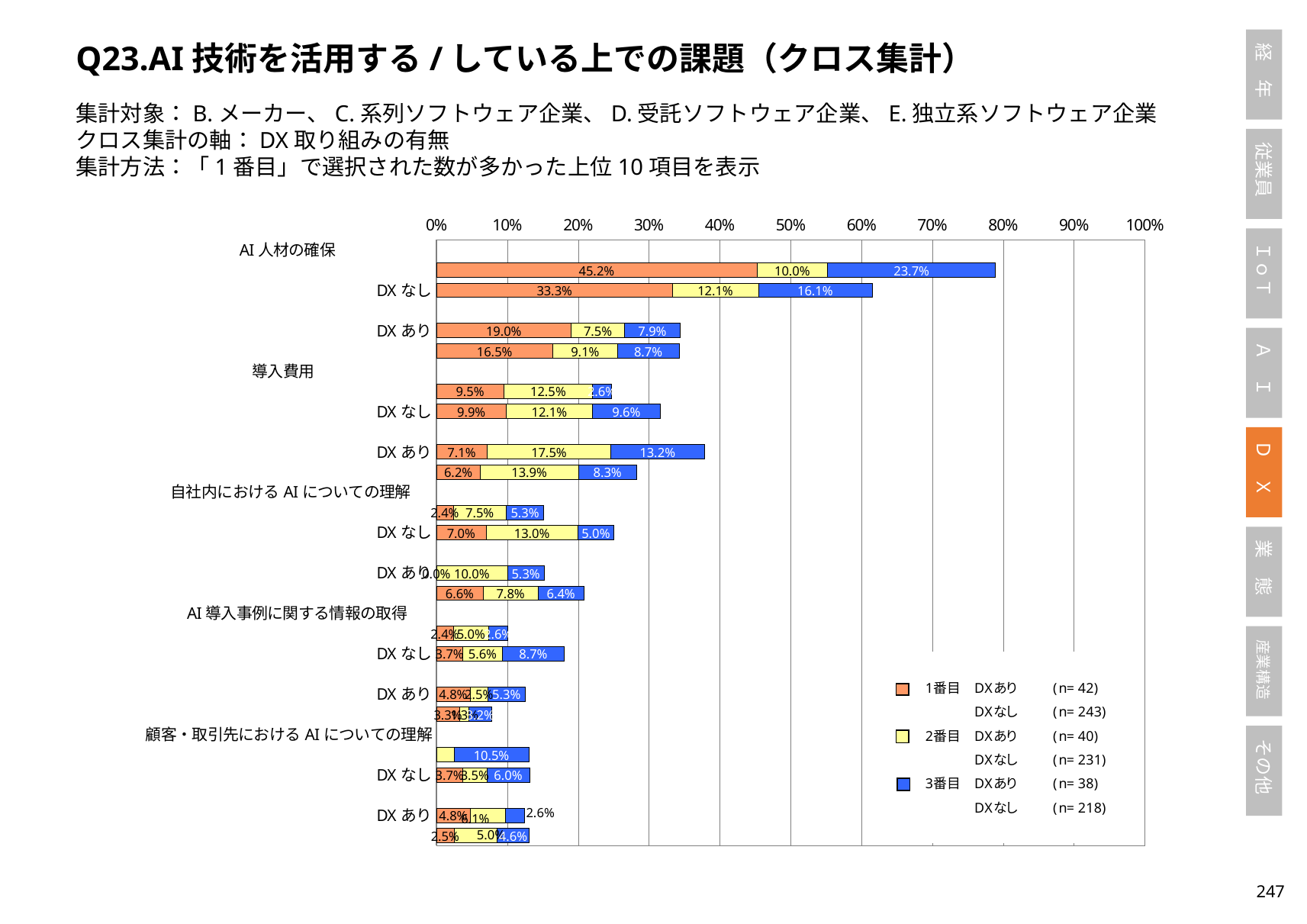
What is the difference between the 1番目 values of the top bar (45.2%) and the second bar (33.3%) under AI 人材の確保? 11.9% In the top bar under AI 人材の確保, what is the value of the 1番目 segment? 45.2% In the top bar under AI 人材の確保, what is the value of the 3番目 segment? 23.7% According to the legend, what is the n value for 1番目 DXなし? n= 243 Which has the larger 1番目 value under AI 人材の確保: the top bar or the second bar? the top bar (45.2%) What kind of chart is shown on the slide? stacked bar chart Which category has the longest bar in the chart? AI 人材の確保 How many series (1番目, 2番目, 3番目) does the legend list? 3 What is the total of the top bar under AI 人材の確保 (45.2%, 10.0%, 23.7%)? 78.9% Is the total length of the top bar under AI 人材の確保 greater or less than 70%? greater What is the total of the second bar under AI 人材の確保 (33.3%, 12.1%, 16.1%)? 61.5% How many category labels (課題 items) are listed on the left of the chart? 5